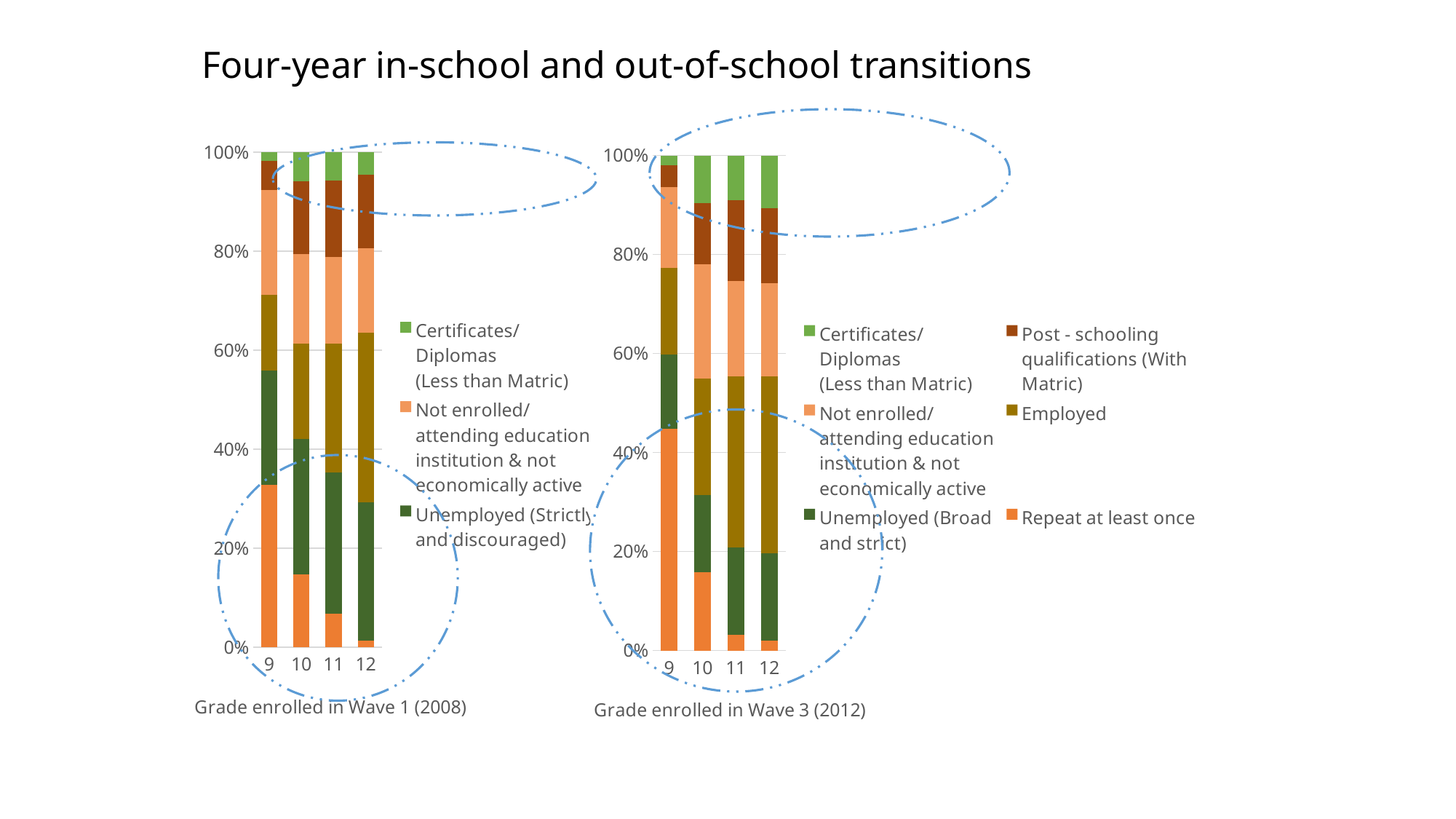
In the 'Grade enrolled in Wave 1 (2008)' chart, is the 'Repeat at least once' (orange) share for grade 9 greater or less than 20%? greater How many series does the legend of the 'Grade enrolled in Wave 3 (2012)' chart list? 6 What kind of chart is used for 'Grade enrolled in Wave 1 (2008)'? Stacked bar chart In the 'Grade enrolled in Wave 3 (2012)' chart, does the 'Repeat at least once' (orange) segment rise or fall from grade 9 to grade 12? Fall In the 'Grade enrolled in Wave 1 (2008)' chart, is the 'Repeat at least once' (orange) share for grade 12 greater or less than 20%? less In the 'Grade enrolled in Wave 3 (2012)' chart, is the 'Repeat at least once' (orange) share for grade 9 greater or less than 40%? greater What is the title of the slide containing the two charts? Four-year in-school and out-of-school transitions How many grade categories are shown on the x axis of the 'Grade enrolled in Wave 3 (2012)' chart? 4 In the 'Grade enrolled in Wave 1 (2008)' chart, is the 'Repeat at least once' (orange) segment larger for grade 9 or grade 12? Grade 9 In the 'Grade enrolled in Wave 3 (2012)' chart, which grade has the smallest 'Repeat at least once' (orange) segment? 12 In the 'Grade enrolled in Wave 1 (2008)' chart, which grade has the largest 'Repeat at least once' (orange) segment? 9